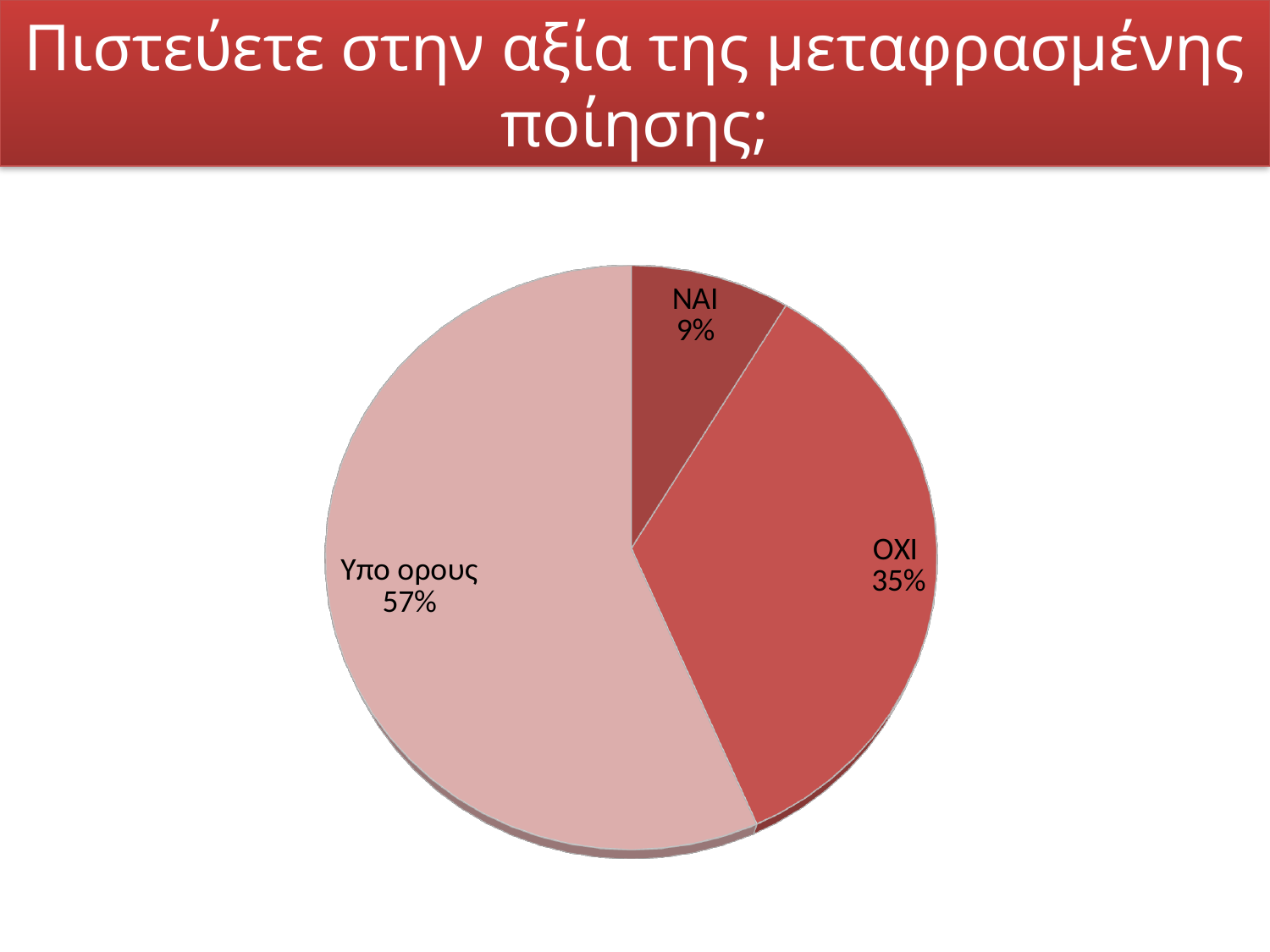
How many slices does the pie chart have? 3 What share of the pie does the ΝΑΙ slice represent? 9% Which is larger, the ΟΧΙ slice or the ΝΑΙ slice? ΟΧΙ What is the title of the slide containing the chart? Πιστεύετε στην αξία της μεταφρασμένης ποίησης; What is the difference in percentage points between the Υπο ορους slice and the ΟΧΙ slice? 22 Which category has the smallest slice of the pie? ΝΑΙ What is the difference in percentage points between the ΟΧΙ slice and the ΝΑΙ slice? 26 Which slice of the pie is the lightest in colour? Υπο ορους Which category has the largest slice of the pie? Υπο ορους What share of the pie does the ΟΧΙ slice represent? 35% What share of the pie does the Υπο ορους slice represent? 57% What kind of chart is shown on the slide? pie chart